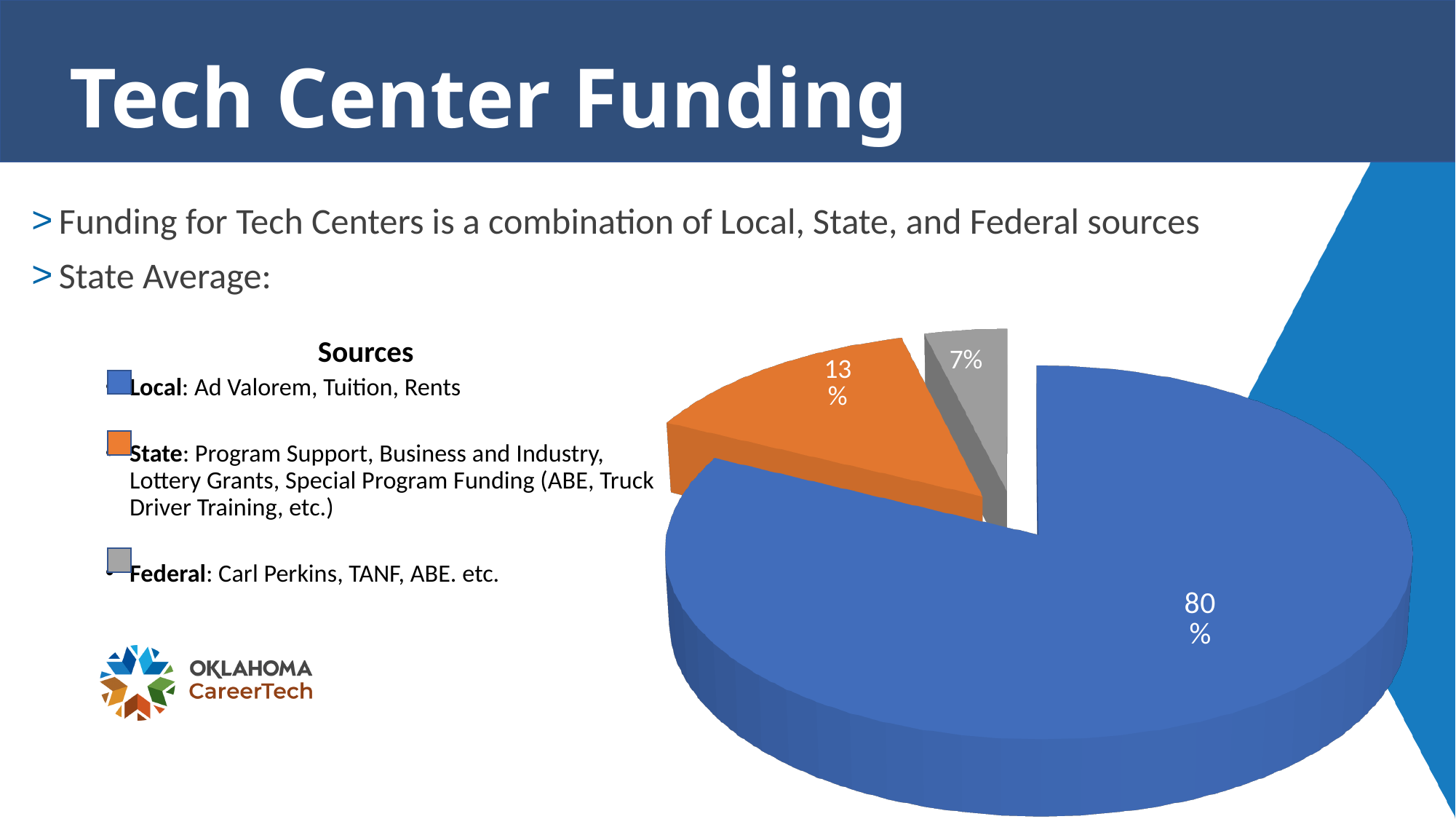
What is the difference in percentage points between the Local and State shares? 67 How many slices does the pie chart have? 3 What is the title of the chart's legend? Sources Which funding source has the smallest share of the pie? Federal What share of Tech Center funding comes from Local sources? 80% What share of Tech Center funding comes from State sources? 13% What kind of chart is shown on the slide? pie chart Which colour represents the State slice in the pie chart? orange What share of Tech Center funding comes from Federal sources? 7% Which funding source has the largest share of the pie? Local What is the difference in percentage points between the State and Federal shares? 6 Which is larger, the State share or the Federal share? State